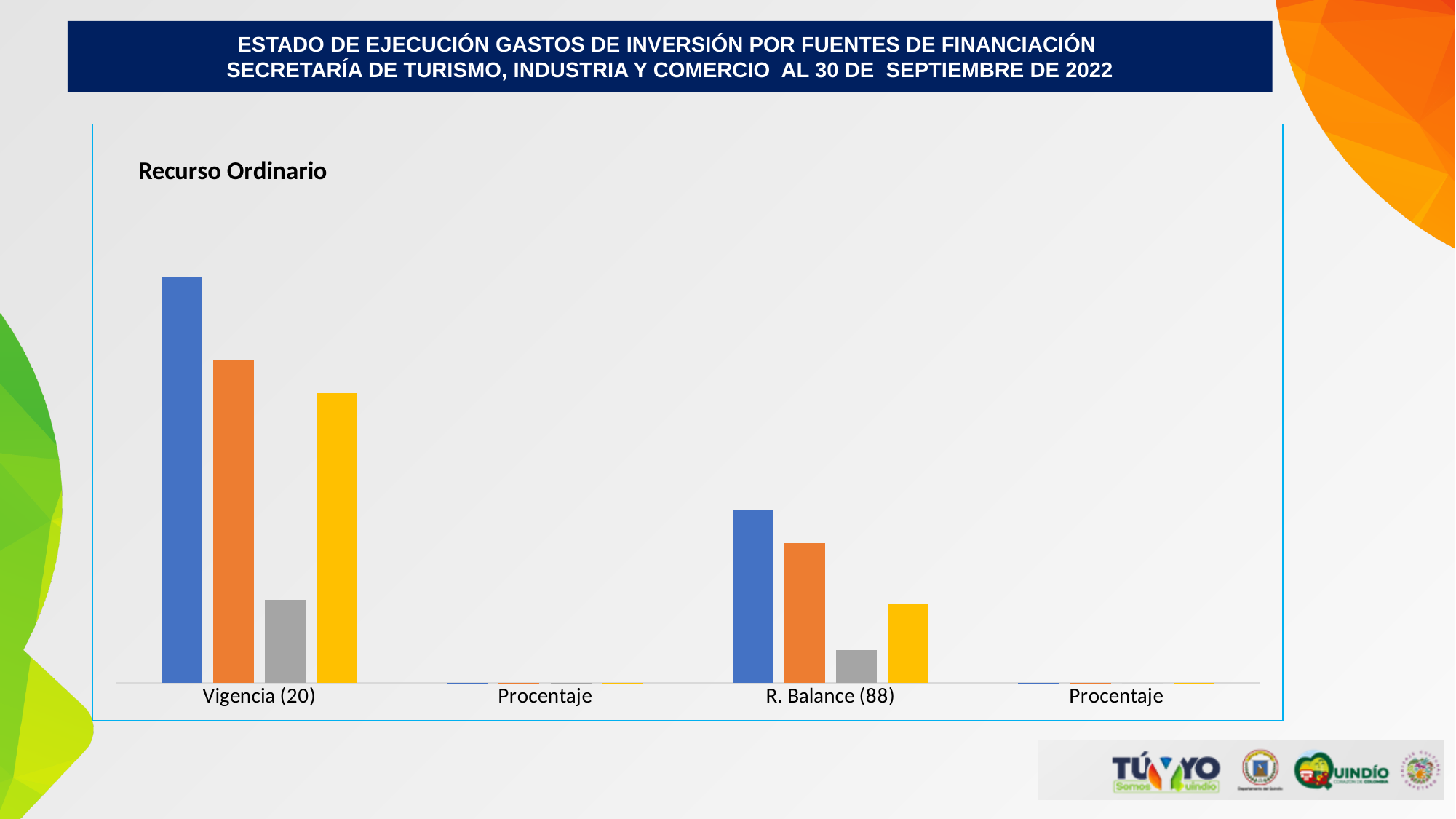
What kind of chart is shown on the slide? bar chart What is the title of the chart? Recurso Ordinario Which category has the tallest bar in the chart? Vigencia (20) Is the yellow bar larger for Vigencia (20) or for R. Balance (88)? Vigencia (20) How many categories are shown on the x axis of the chart? 4 What is the label of the third category on the x axis? R. Balance (88) Within the category Vigencia (20), which coloured bar is the shortest? gray Within the category R. Balance (88), which coloured bar is the tallest? blue Is the blue bar larger for Vigencia (20) or for R. Balance (88)? Vigencia (20) Within the category Vigencia (20), which coloured bar is the tallest? blue How many bars are plotted for the category Vigencia (20)? 4 Within the category R. Balance (88), which coloured bar is the shortest? gray